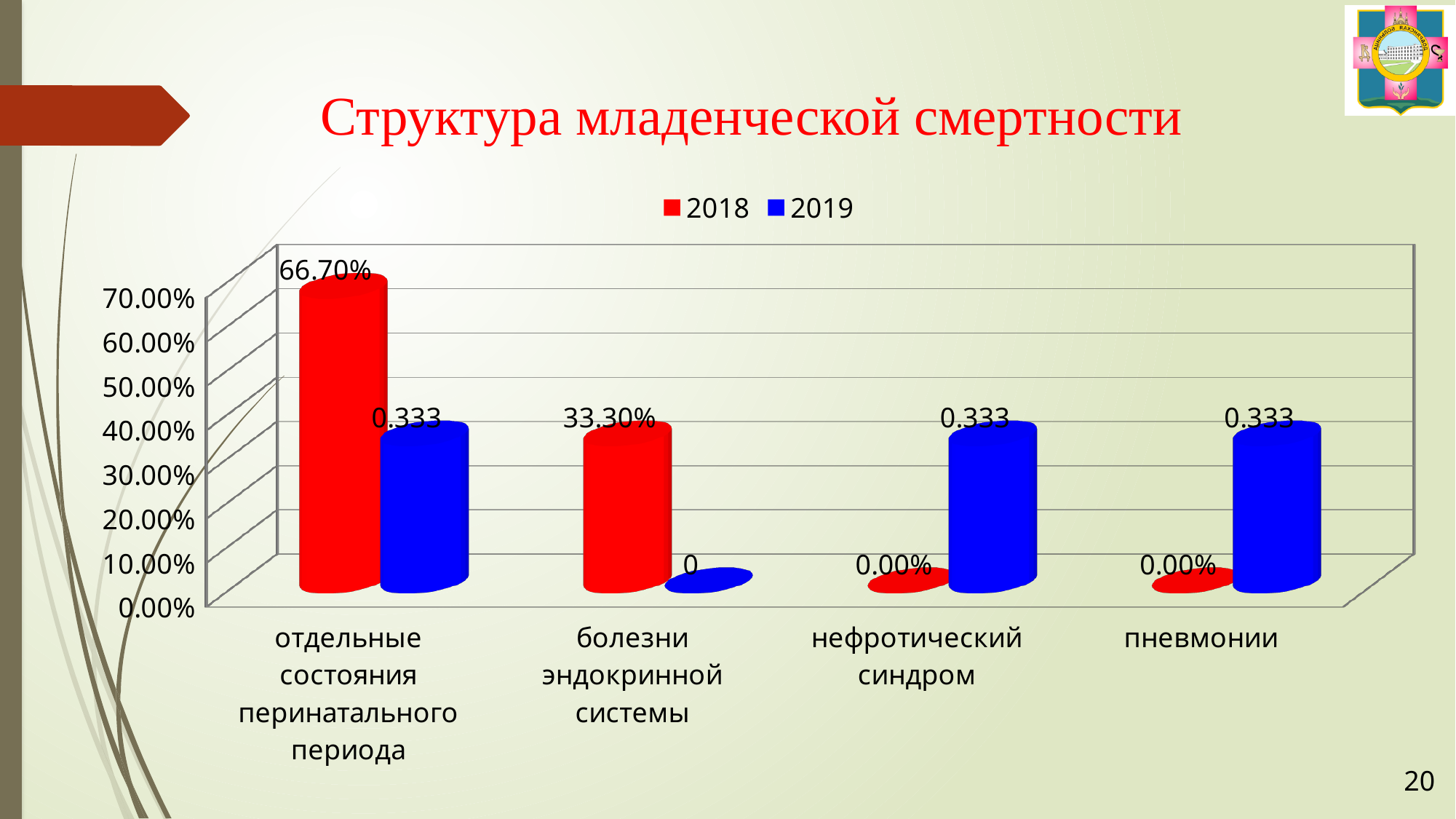
What is the value for 2019 for пневмонии? 0.333 Which category has the lowest value for 2019? болезни эндокринной системы What is the value for 2018 for нефротический синдром? 0.00% What is the value for 2018 for отдельные состояния перинатального периода? 66.70% Which category has the highest value for 2018? отдельные состояния перинатального периода How many series does the legend list? 2 What is the difference between the 2018 values for отдельные состояния перинатального периода and болезни эндокринной системы? 33.40% What is the value for 2018 for болезни эндокринной системы? 33.30% What is the title of the chart? Структура младенческой смертности What is the value for 2019 for болезни эндокринной системы? 0 For болезни эндокринной системы, which series has the larger value, 2018 or 2019? 2018 How many categories are shown on the x axis? 4